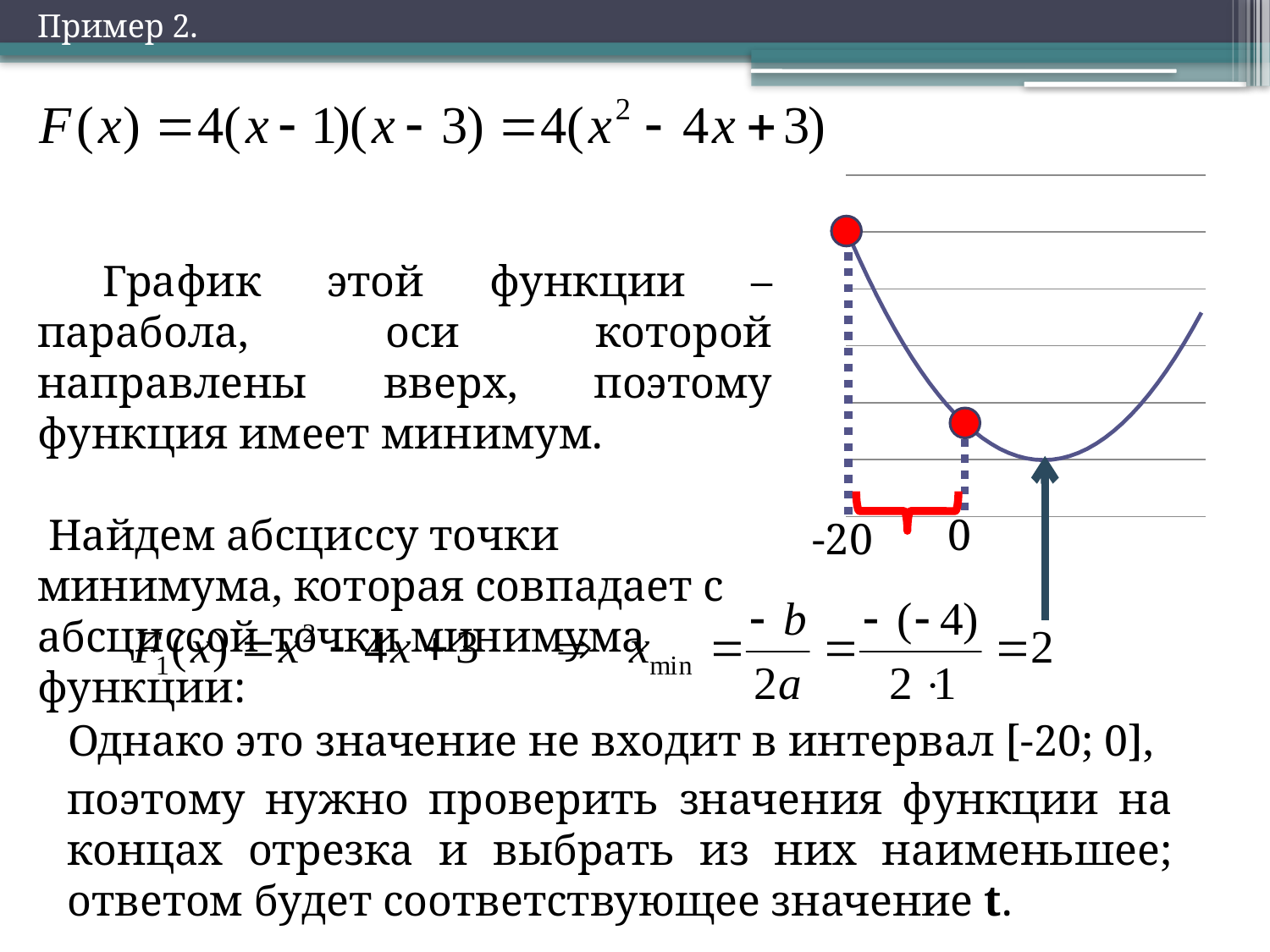
Which marked point is higher on the curve, the one at x = -20 or the one at x = 0? x = -20 Between the marked points at x = -20 and x = 0, does the curve rise or fall as x increases? fall How many red marked points are shown on the curve? 2 What kind of chart is shown on the right side of the slide? line chart Which two x-axis values are labelled under the curve? -20 and 0 Does the curve have its lowest point to the left or to the right of the marked point at x = 0? to the right What is the leftmost x-axis label shown on the chart? -20